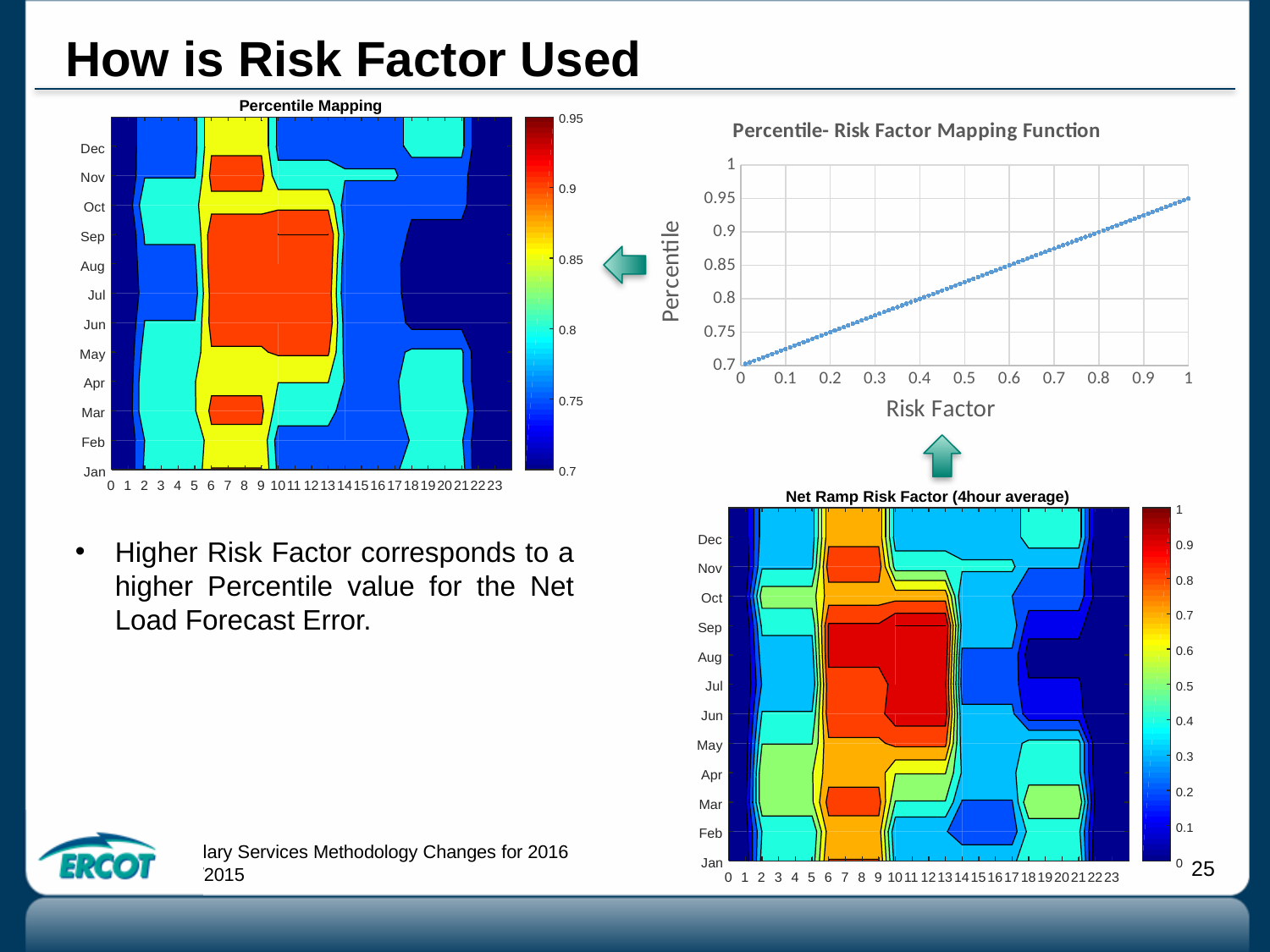
In the 'Percentile- Risk Factor Mapping Function' chart, which is larger: the Percentile at Risk Factor 0.9 or at Risk Factor 0.1? Risk Factor 0.9 In the 'Percentile- Risk Factor Mapping Function' chart, is the Percentile at a Risk Factor of 0.5 greater or less than 0.8? greater What is the highest value shown on the colour scale of the 'Net Ramp Risk Factor (4hour average)' chart? 1 How many hour values (0 to 23) are shown on the x axis of the 'Percentile Mapping' chart? 24 In the 'Percentile- Risk Factor Mapping Function' chart, what is the title of the x axis? Risk Factor In the 'Percentile- Risk Factor Mapping Function' chart, what is the Percentile when the Risk Factor is 0? 0.7 In the 'Percentile- Risk Factor Mapping Function' chart, is the Percentile at a Risk Factor of 0.2 greater or less than 0.8? less What kind of chart is the 'Percentile- Risk Factor Mapping Function' chart? scatter chart In the 'Percentile- Risk Factor Mapping Function' chart, what is the Percentile when the Risk Factor is 1? 0.95 In the 'Percentile- Risk Factor Mapping Function' chart, does the Percentile rise or fall as the Risk Factor increases from 0 to 1? rise How many months are listed on the y axis of the 'Net Ramp Risk Factor (4hour average)' chart? 12